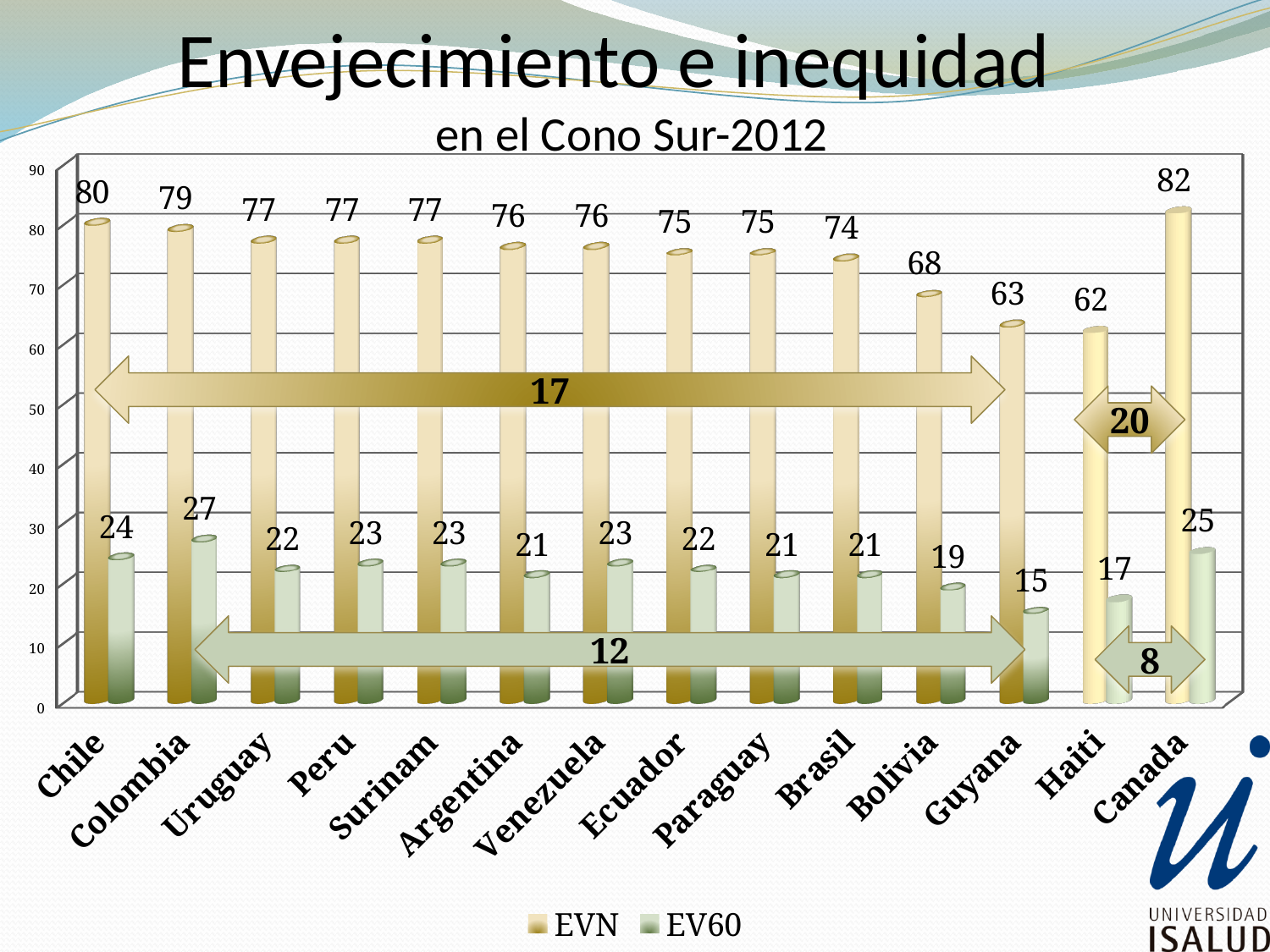
Which country has the lowest EVN value? Haiti Which country has the lowest EV60 value? Guyana What is the EV60 value for Haiti? 17 Which country has the highest EVN value? Canada Which is larger, the EV60 value for Chile or the EV60 value for Canada? Canada What kind of chart is shown on the slide? Bar chart What is the EV60 value for Colombia? 27 How many series does the legend list? 2 How many countries are shown on the x axis? 14 What is the difference between the EVN values of Canada and Haiti? 20 What is the EVN value for Chile? 80 What is the EVN value for Bolivia? 68